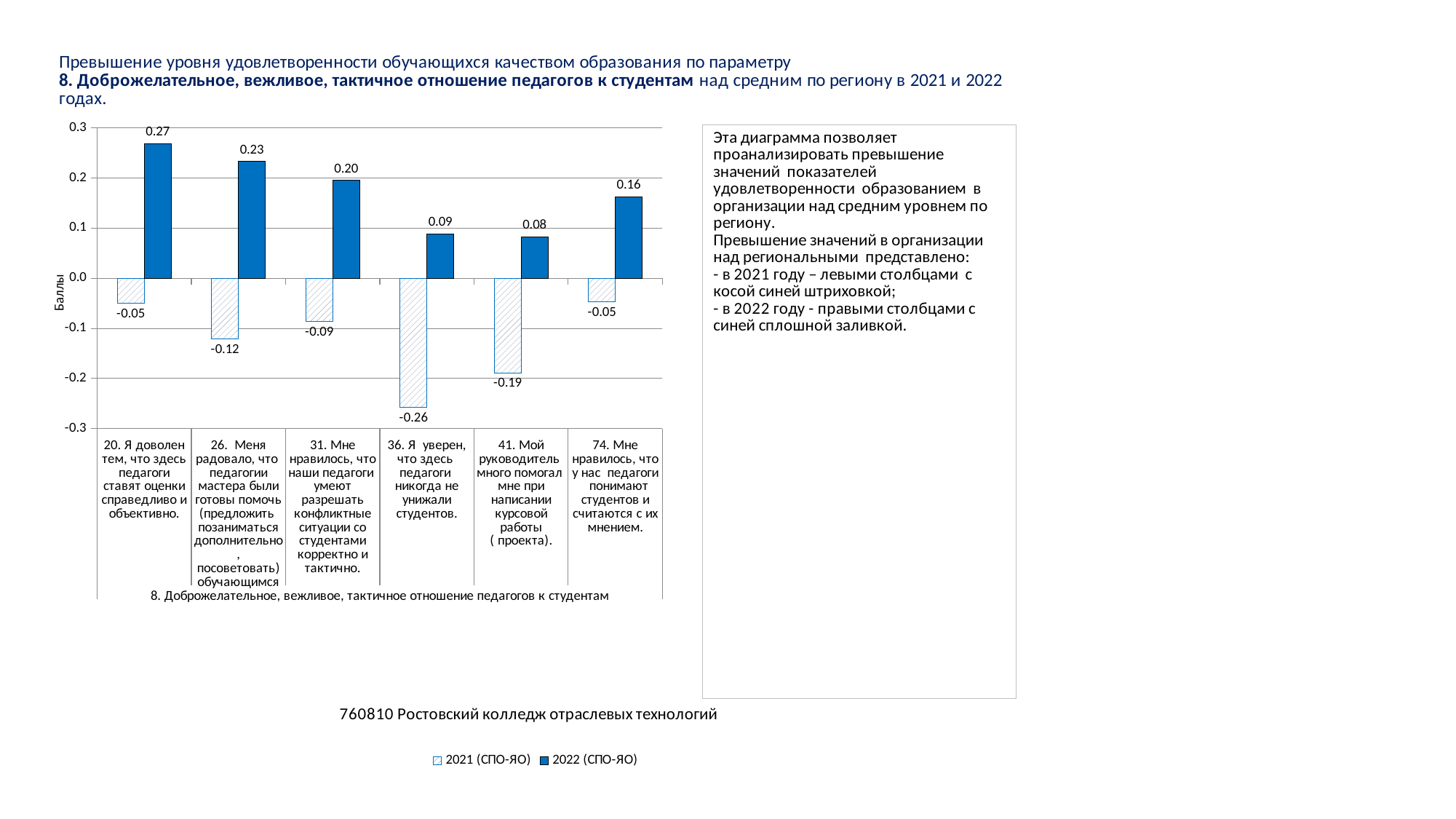
How many categories are shown on the x axis of the chart? 6 What is the value for 2021 (СПО-ЯО) for category 41 (Мой руководитель много помогал мне при написании курсовой работы)? -0.19 What is the label of the y axis of the chart? Баллы Which category has the lowest value for the 2021 (СПО-ЯО) series? 36. Я уверен, что здесь педагоги никогда не унижали студентов. Which category has the highest value for the 2022 (СПО-ЯО) series? 20. Я доволен тем, что здесь педагоги ставят оценки справедливо и объективно. What is the difference between the 2022 and 2021 values for category 26 (Меня радовало, что педагоги мастера были готовы помочь)? 0.35 What is the value for 2022 (СПО-ЯО) for category 74 (Мне нравилось, что у нас педагоги понимают студентов и считаются с их мнением)? 0.16 How many series does the legend list? 2 What is the value for 2021 (СПО-ЯО) for category 36 (Я уверен, что здесь педагоги никогда не унижали студентов)? -0.26 What is the value for 2022 (СПО-ЯО) for category 20 (Я доволен тем, что здесь педагоги ставят оценки справедливо и объективно)? 0.27 What kind of chart is shown on the slide? Bar chart Which is larger: the 2022 value for category 36 or the 2022 value for category 41? Category 36 (0.09)